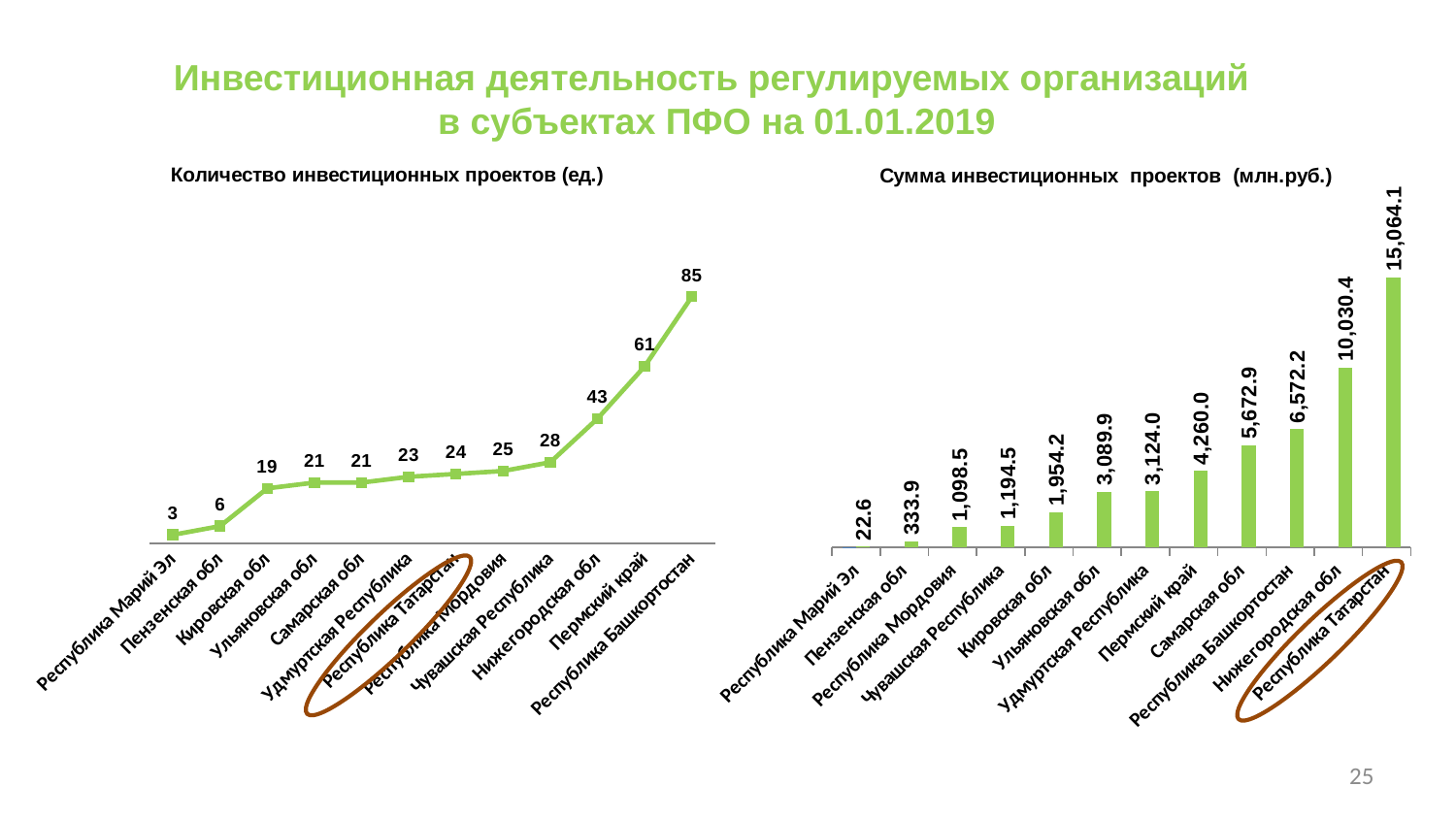
In the chart 'Сумма инвестиционных проектов (млн.руб.)', how many regions are shown? 12 In the chart 'Сумма инвестиционных проектов (млн.руб.)', what is the value for Самарская обл? 5,672.9 In the chart 'Количество инвестиционных проектов (ед.)', which region has the lowest value? Республика Марий Эл In the chart 'Количество инвестиционных проектов (ед.)', what kind of chart is shown? Line chart In the chart 'Сумма инвестиционных проектов (млн.руб.)', what kind of chart is shown? Bar chart In the chart 'Сумма инвестиционных проектов (млн.руб.)', what is the value for Республика Татарстан? 15,064.1 In the chart 'Сумма инвестиционных проектов (млн.руб.)', which region has the lowest value? Республика Марий Эл In the chart 'Количество инвестиционных проектов (ед.)', which region has the highest value? Республика Башкортостан In the chart 'Количество инвестиционных проектов (ед.)', do the values rise or fall from left to right? Rise In the chart 'Количество инвестиционных проектов (ед.)', what is the difference between Республика Башкортостан and Пермский край? 24 In the chart 'Сумма инвестиционных проектов (млн.руб.)', which is larger: Нижегородская обл or Республика Башкортостан? Нижегородская обл In the chart 'Количество инвестиционных проектов (ед.)', what is the value for Республика Татарстан? 24